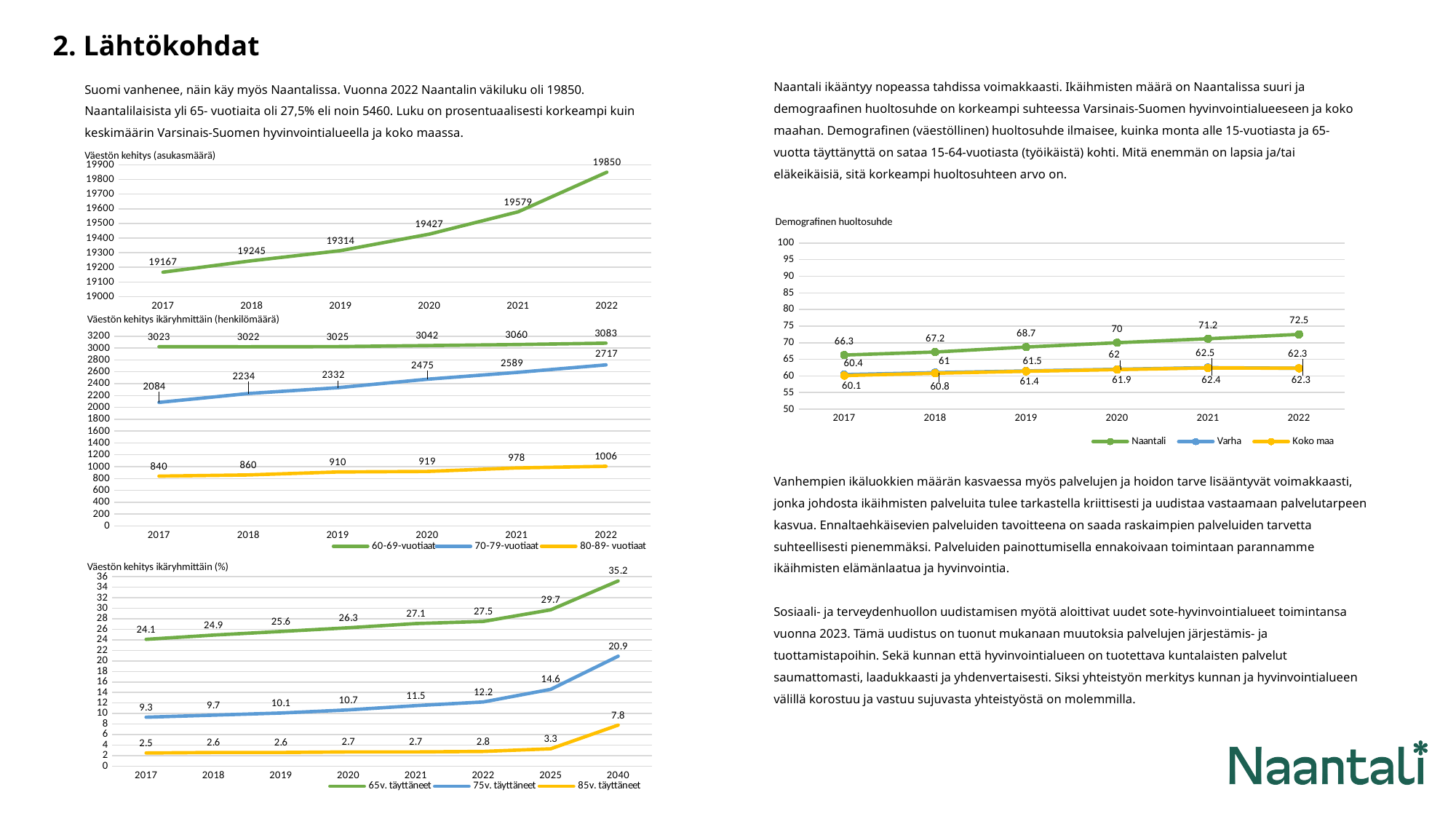
In the 'Väestön kehitys (asukasmäärä)' chart, what is the difference between the 2022 and 2017 values? 683 In the 'Demografinen huoltosuhde' chart, which series has the highest value in 2022? Naantali In the 'Väestön kehitys ikäryhmittäin (%)' chart, what is the value for 65v. täyttäneet in 2040? 35.2 In the 'Väestön kehitys (asukasmäärä)' chart, do the values rise or fall from 2017 to 2022? rise In the 'Väestön kehitys ikäryhmittäin (%)' chart, what is the difference between 75v. täyttäneet in 2040 and in 2025? 6.3 In the 'Väestön kehitys ikäryhmittäin (henkilömäärä)' chart, which year has the lowest value for 80-89- vuotiaat? 2017 In the 'Väestön kehitys ikäryhmittäin (henkilömäärä)' chart, what is the value for 70-79-vuotiaat in 2020? 2475 In the 'Demografinen huoltosuhde' chart, what is the value for Naantali in 2021? 71.2 In the 'Väestön kehitys ikäryhmittäin (%)' chart, how many years are shown on the x axis? 8 In the 'Väestön kehitys (asukasmäärä)' chart, what is the value for 2022? 19850 What kind of chart is the 'Demografinen huoltosuhde' chart? line chart In the 'Väestön kehitys ikäryhmittäin (henkilömäärä)' chart, how many series does the legend list? 3